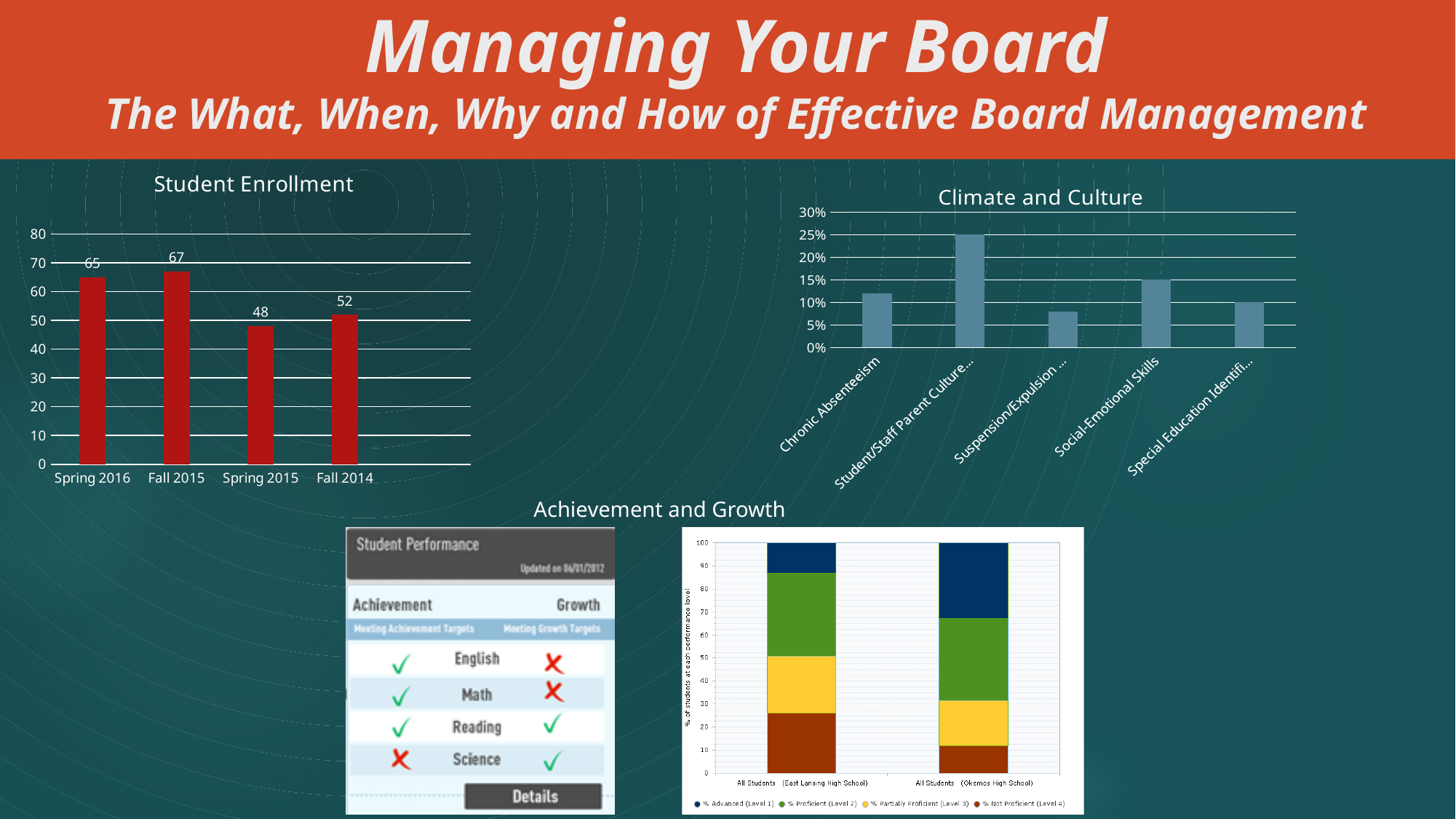
How many periods are shown in the Student Enrollment chart? 4 In the Student Enrollment chart, what is the value for Spring 2015? 48 In the Student Enrollment chart, what is the difference between Fall 2015 and Spring 2015? 19 In the Climate and Culture chart, which category has the highest value? Student/Staff Parent Culture... In the Student Enrollment chart, what is the value for Spring 2016? 65 In the Climate and Culture chart, which category has the lowest value? Suspension/Expulsion ... In the Climate and Culture chart, is the value for Student/Staff Parent Culture greater or less than 20%? greater In the Climate and Culture chart, is the value for Chronic Absenteeism greater or less than 15%? less In the Student Enrollment chart, which period has the highest enrollment? Fall 2015 In the Student Enrollment chart, which period has the lowest enrollment? Spring 2015 How many series does the legend of the Achievement and Growth stacked bar chart list? 4 In the Student Enrollment chart, which is larger, Fall 2014 or Spring 2016? Spring 2016